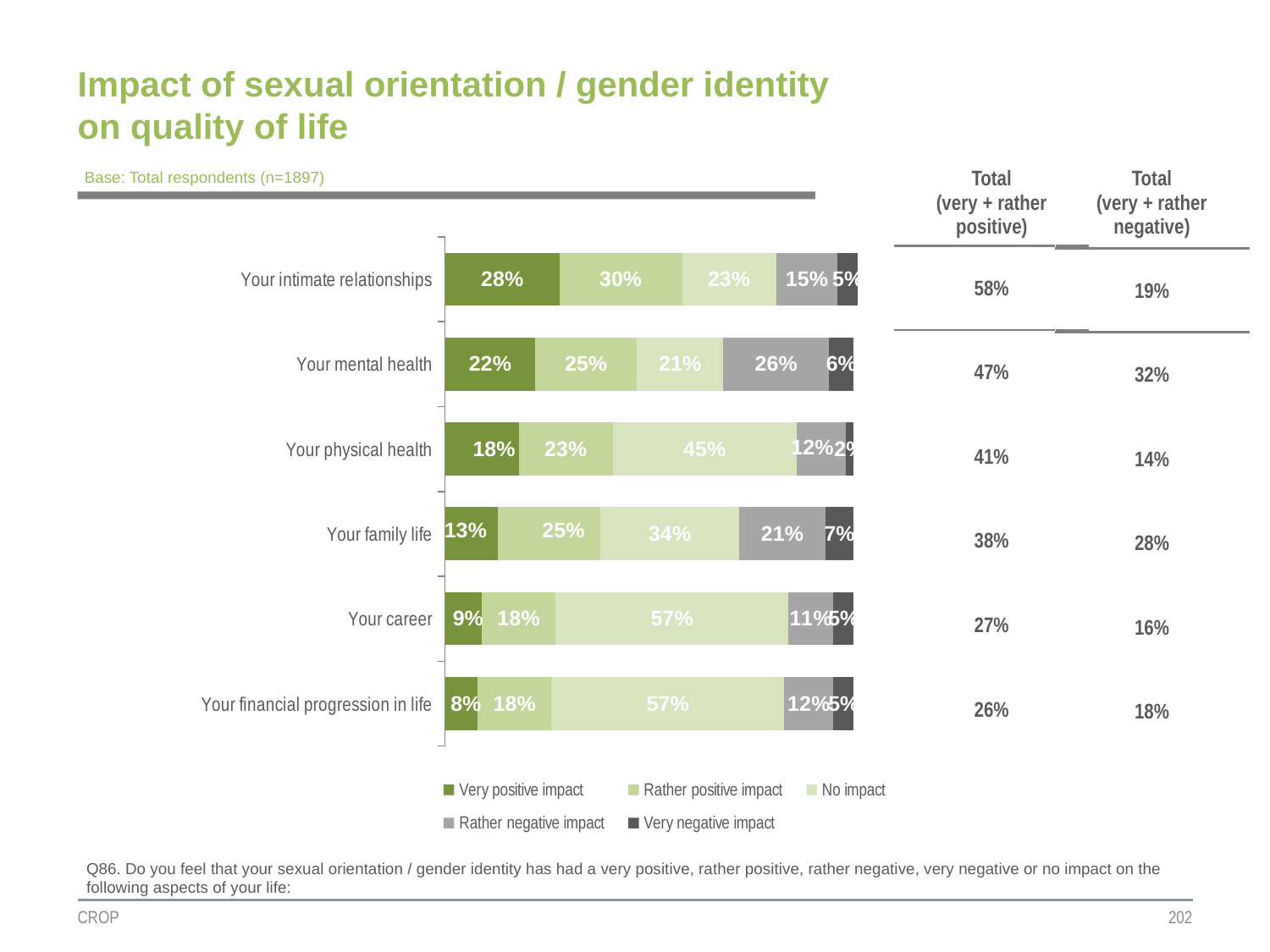
Which aspect of life has the highest 'Rather negative impact' value? Your mental health What kind of chart is shown on the slide? Stacked bar chart Which has a larger 'Rather positive impact' value: 'Your intimate relationships' or 'Your family life'? Your intimate relationships How many series does the legend list? 5 Which aspect of life has the lowest 'Very positive impact' value? Your financial progression in life What is the 'No impact' value for 'Your physical health'? 45% What is the 'Rather negative impact' value for 'Your mental health'? 26% Which aspect of life has the highest 'Very positive impact' value? Your intimate relationships What is the difference between the 'No impact' value for 'Your career' and for 'Your intimate relationships'? 34 percentage points What percentage of respondents reported a very positive impact on their intimate relationships? 28% According to the 'Total (very + rather negative)' column, what is the value for 'Your mental health'? 32% How many aspects of life are shown in the chart? 6